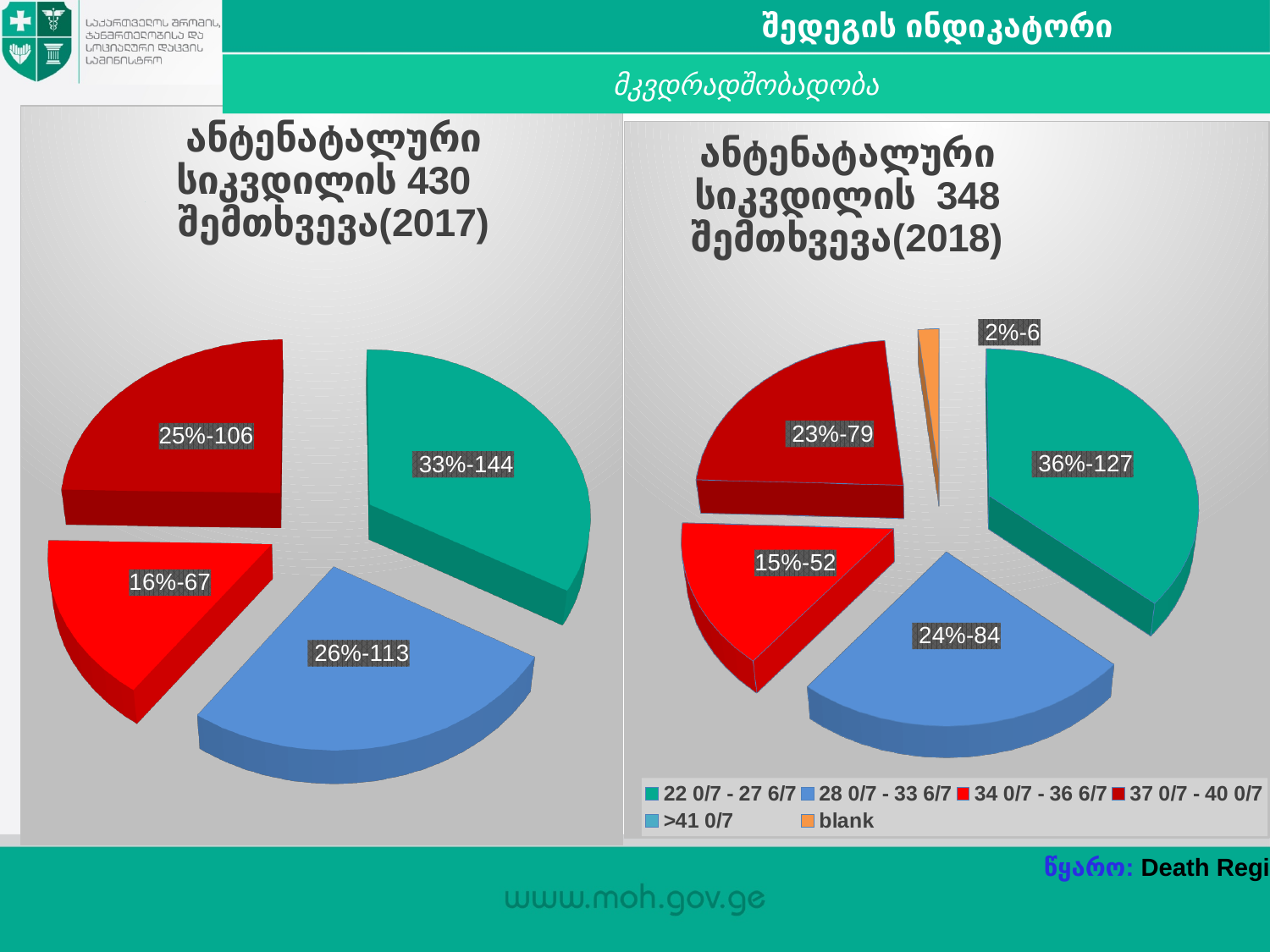
In the left pie chart (2017), what is the label on the teal slice for the 22 0/7 - 27 6/7 category? 33%-144 In the left pie chart (2017), what is the label on the blue slice for the 28 0/7 - 33 6/7 category? 26%-113 In the right pie chart (2018), which is larger: the 34 0/7 - 36 6/7 slice or the 37 0/7 - 40 0/7 slice? 37 0/7 - 40 0/7 How many entries does the legend below the right pie chart list? 6 In the right pie chart (2018), which category has the largest slice? 22 0/7 - 27 6/7 In the right pie chart (2018), what is the difference in count between the 22 0/7 - 27 6/7 slice and the 28 0/7 - 33 6/7 slice? 43 What type of chart is shown on the left side of the slide (2017)? pie chart In the left pie chart (2017), which category has the smallest slice? 34 0/7 - 36 6/7 In the right pie chart (2018), what share of the pie does the 28 0/7 - 33 6/7 slice represent? 24% In the left pie chart (2017), what is the difference in count between the 37 0/7 - 40 0/7 slice and the 34 0/7 - 36 6/7 slice? 39 How many slices does the right pie chart (2018) have? 5 In the right pie chart (2018), what is the label on the orange 'blank' slice? 2%-6